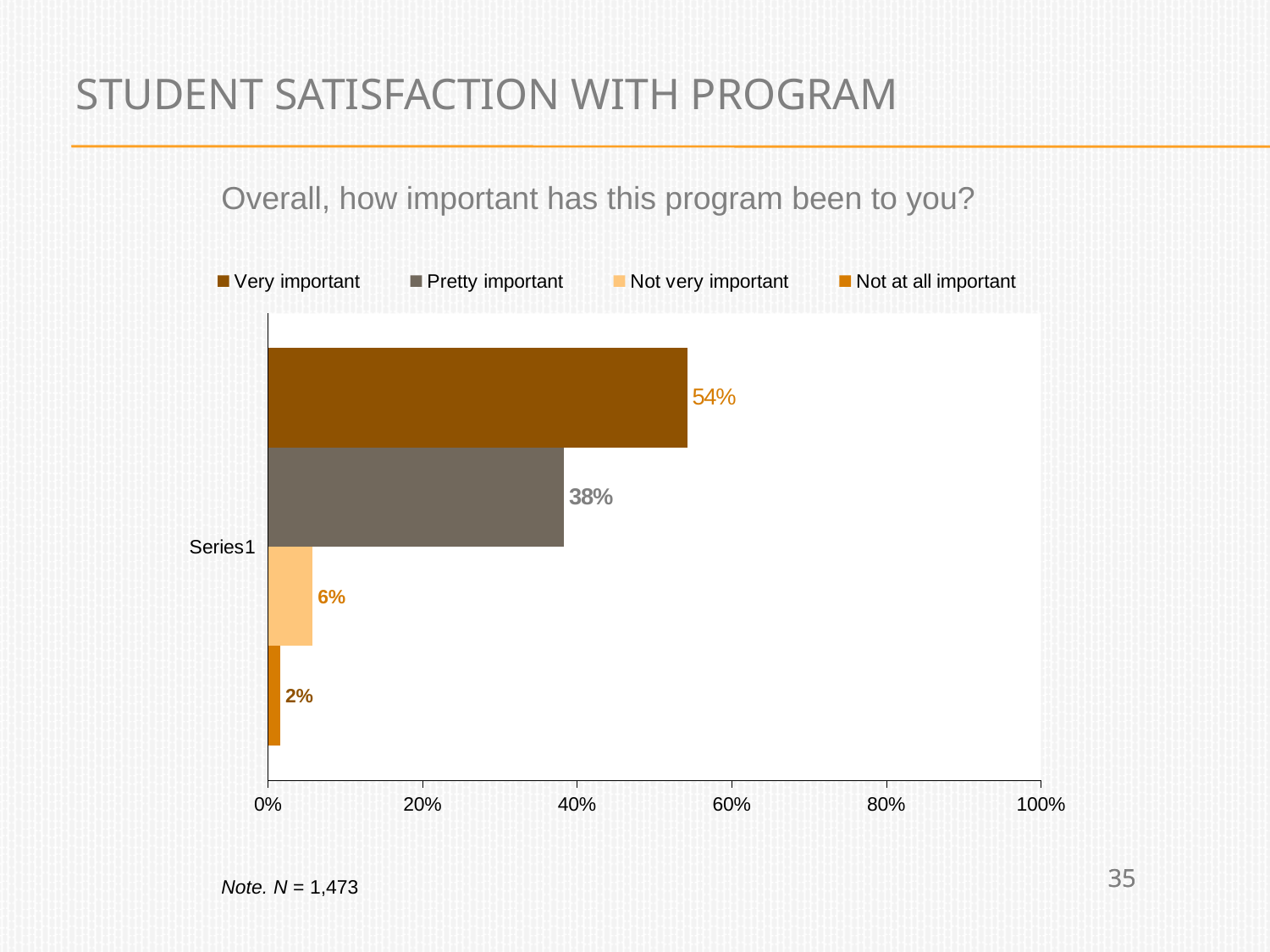
How many series does the legend list? 4 What percentage of students said the program was not very important? 6% What question is the chart reporting responses to? Overall, how important has this program been to you? What percentage of students said the program was not at all important? 2% What percentage of students said the program was very important to them? 54% What percentage of students said the program was pretty important? 38% What kind of chart is shown on the slide? Bar chart Which is larger, the percentage for 'Not very important' or for 'Not at all important'? Not very important Which response category has the lowest percentage? Not at all important Which response category has the highest percentage? Very important Is the value for 'Pretty important' greater or less than 40%? less What is the difference in percentage points between 'Very important' and 'Pretty important'? 16